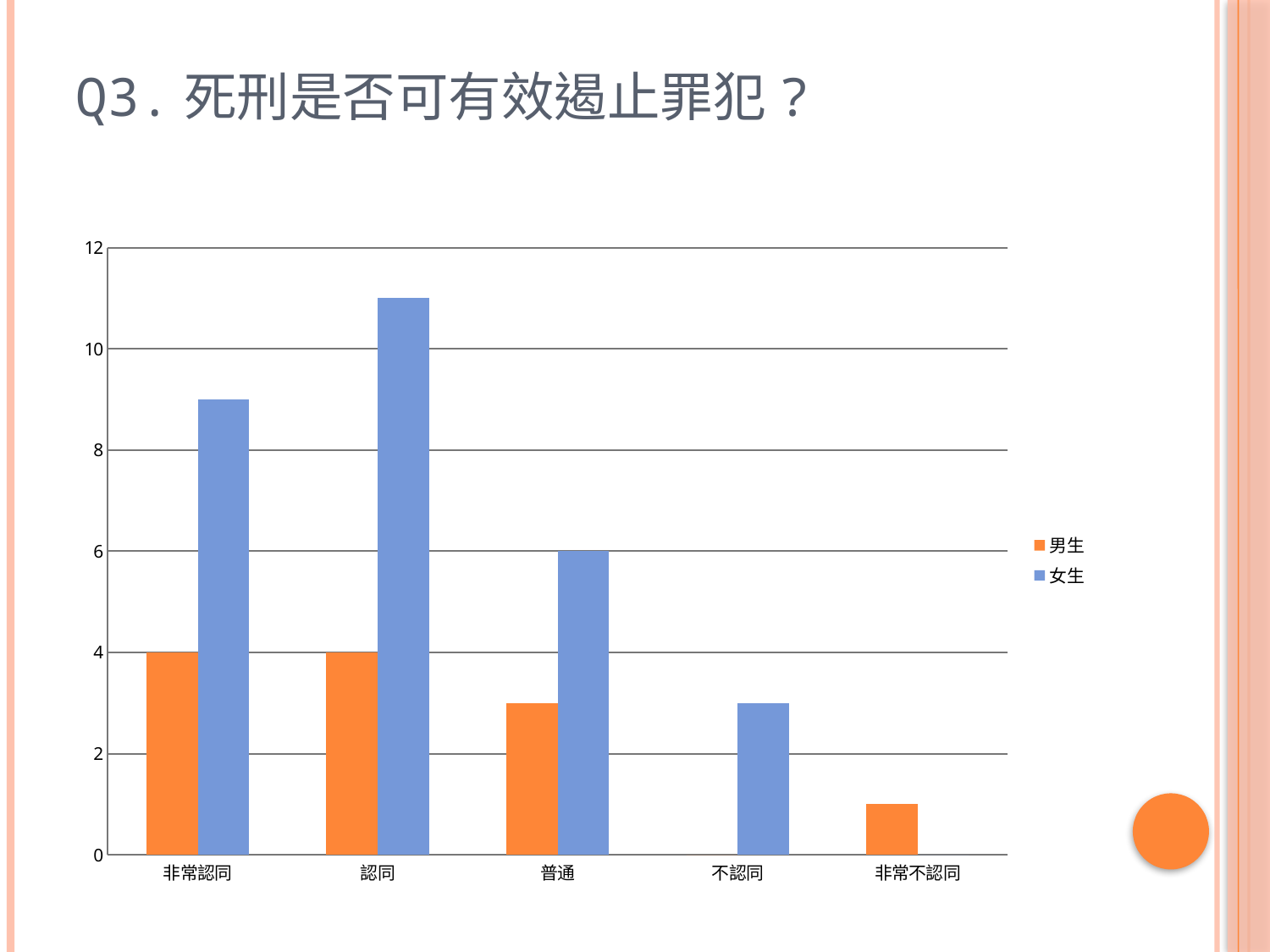
What is the value for 男生 in the 非常認同 category? 4 Is the 男生 value for 非常不認同 greater or less than 2? less How many series does the legend list? 2 Is the 女生 value for 非常認同 greater or less than 8? greater Is the 女生 value for 不認同 greater or less than 2? greater In the 非常認同 category, which is larger, 男生 or 女生? 女生 What is the difference between the 女生 value for 普通 and the 男生 value for 非常認同? 2 What is the value for 女生 in the 普通 category? 6 How many categories are shown on the x axis? 5 What is the value for 男生 in the 認同 category? 4 Which category has the highest 女生 value? 認同